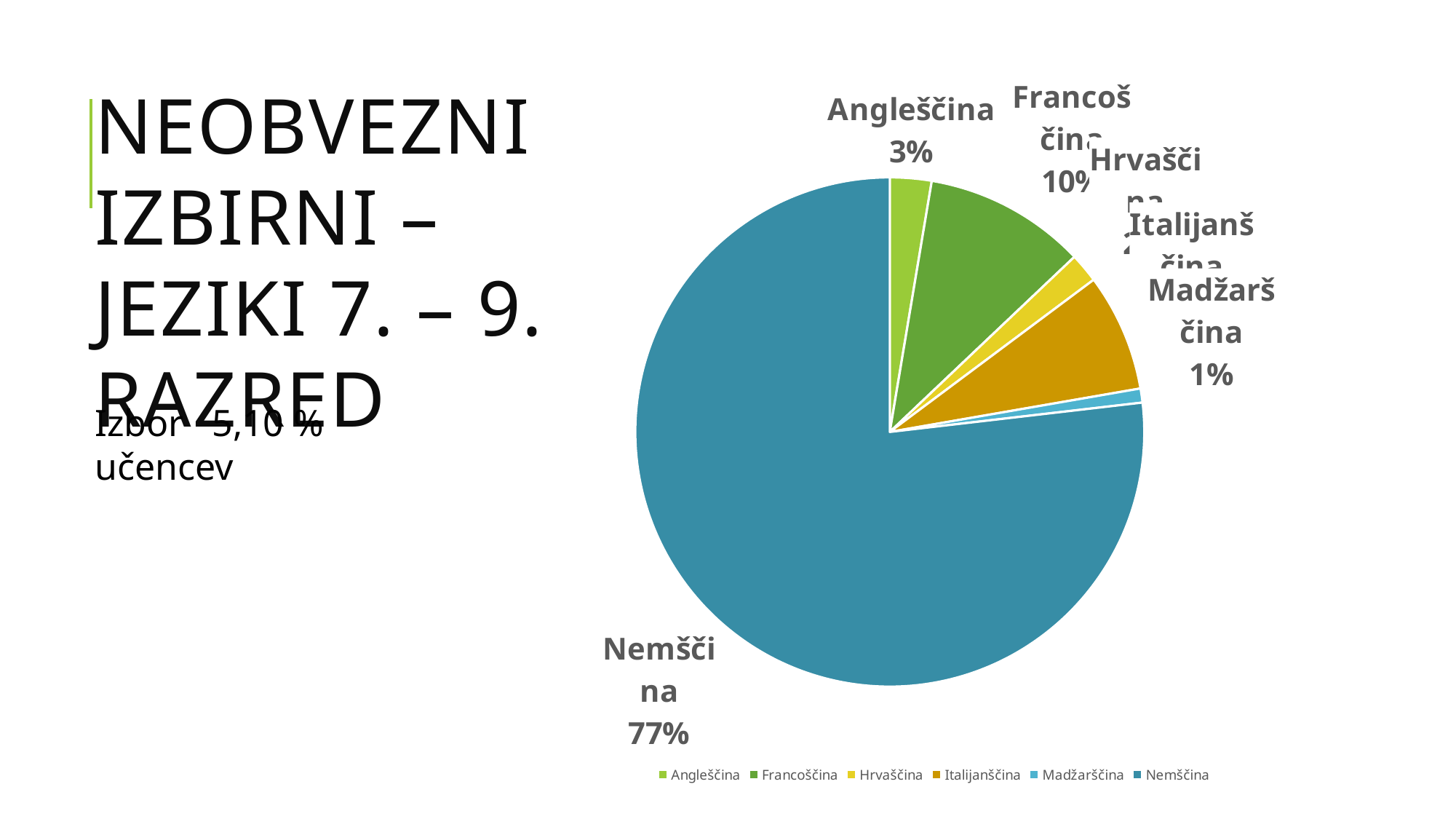
Which language has the largest slice of the pie chart? Nemščina By how many percentage points does Francoščina exceed Angleščina? 7 By how many percentage points does Nemščina exceed Francoščina? 67 What is the value shown for Madžarščina? 1% Which is larger, the slice for Francoščina or the slice for Angleščina? Francoščina What is the value shown for Angleščina? 3% How many entries does the legend list? 6 What share of the pie does Nemščina have? 77% What kind of chart is shown on the slide? pie chart How many categories does the pie chart show? 6 What is the value shown for Francoščina? 10% Which language is shown in the dark orange colour in the legend? Italijanščina